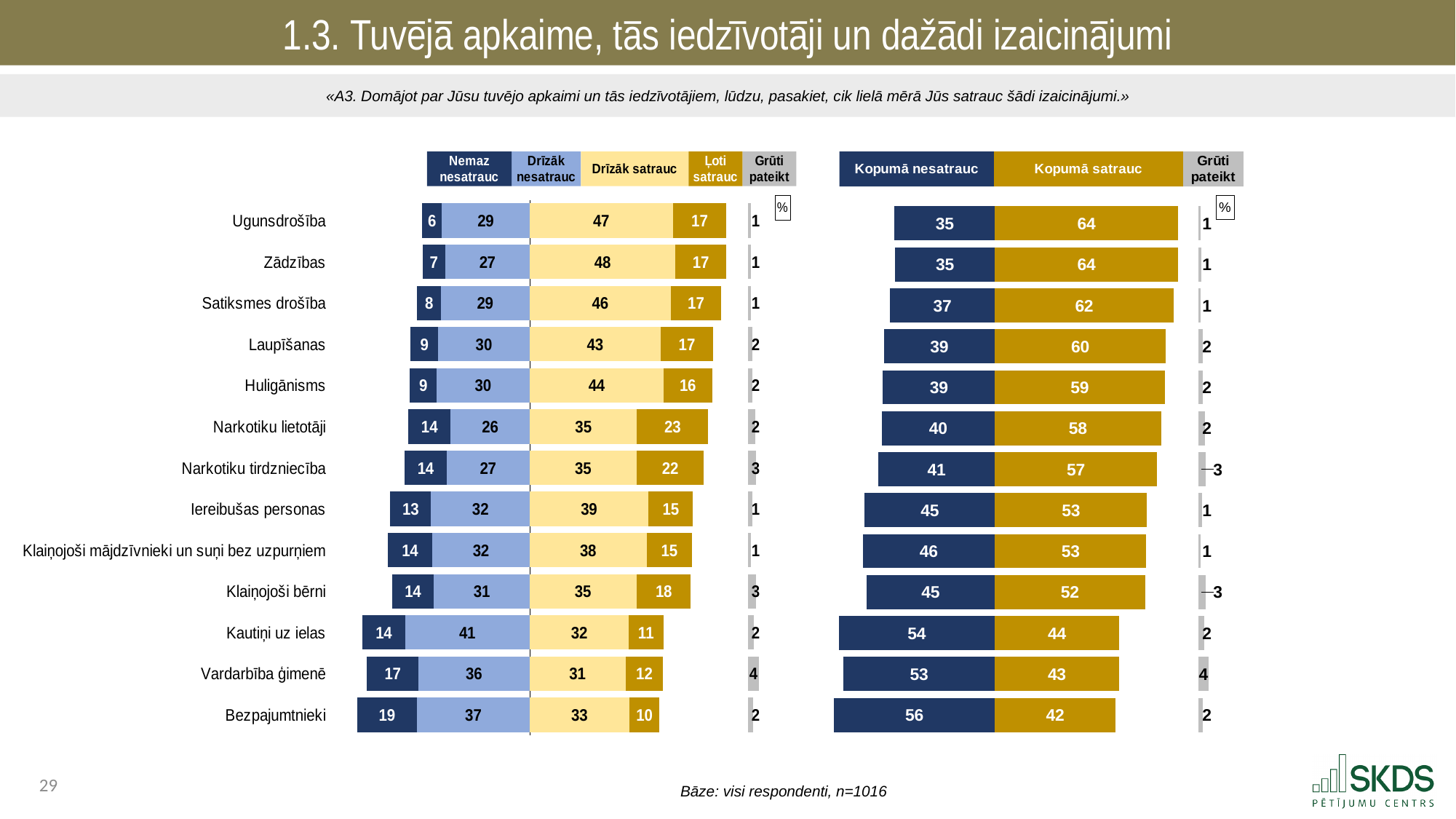
In the right chart, what is the difference between the 'Kopumā satrauc' values for Ugunsdrošība and Kautiņi uz ielas? 20 In the left chart, which is larger: the 'Drīzāk nesatrauc' value for Kautiņi uz ielas or for Vardarbība ģimenē? Kautiņi uz ielas How many categories are listed in the left chart? 13 In the left chart, what is the total of the 'Nemaz nesatrauc' and 'Drīzāk nesatrauc' segments for Laupīšanas? 39 How many series does the legend of the left chart list? 5 In the left chart, what is the 'Nemaz nesatrauc' value for Bezpajumtnieki? 19 In the left chart, what is the 'Drīzāk satrauc' value for Zādzības? 48 In the right chart, which category has the lowest 'Kopumā satrauc' value? Bezpajumtnieki In the left chart, which category has the highest 'Ļoti satrauc' value? Narkotiku lietotāji What kind of chart is the right chart? Stacked bar chart How many series does the legend of the right chart list? 3 In the right chart, what is the 'Kopumā satrauc' value for Huligānisms? 59